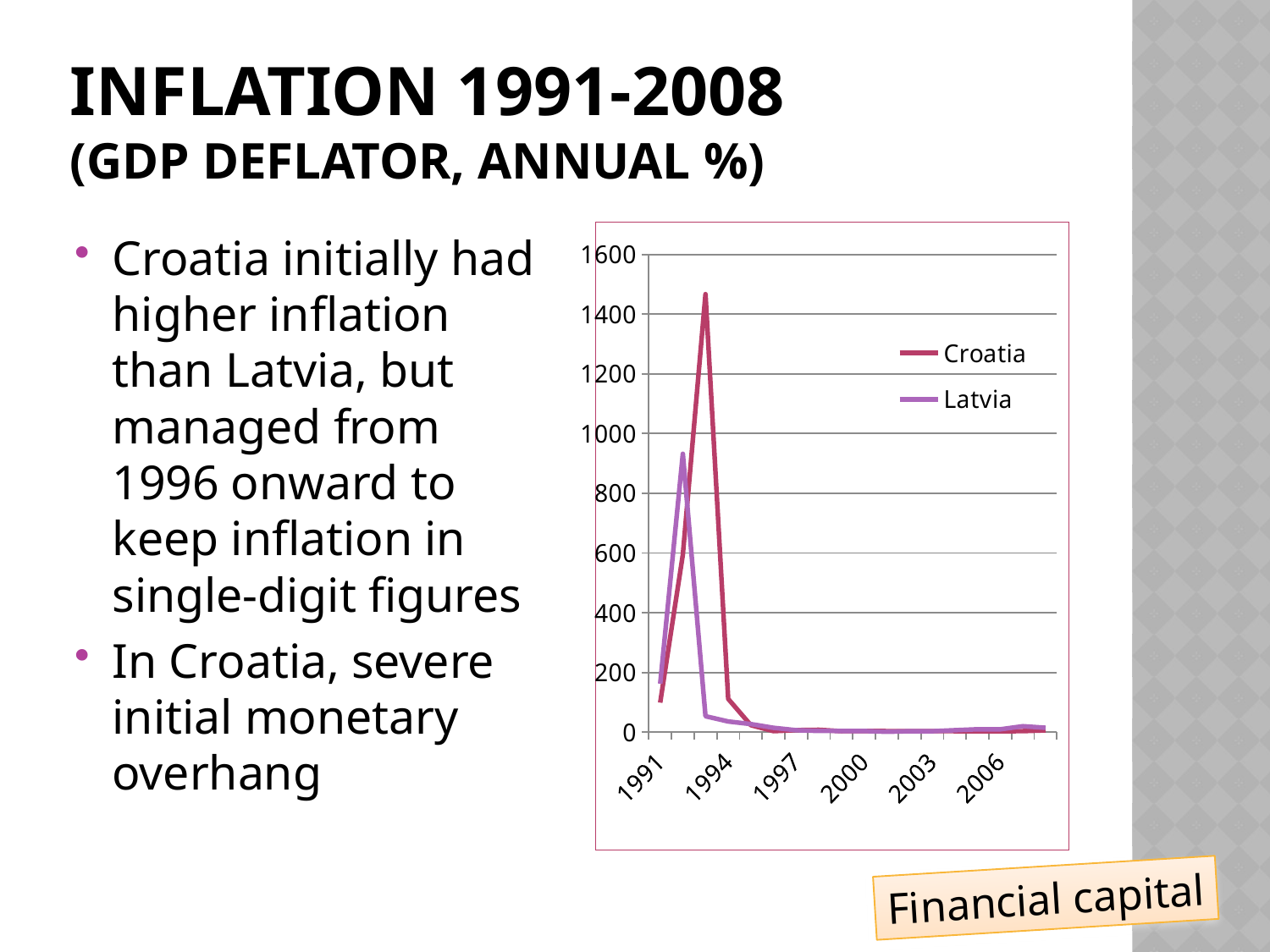
Which series reaches the higher peak value, Croatia or Latvia? Croatia What is the highest value shown on the chart's vertical axis? 1600 Is the peak value for Croatia greater or less than 1400? greater Which two countries are shown in the chart legend? Croatia and Latvia After reaching its peak, does the Croatia line rise or fall over the following years? fall How many year labels are printed along the x axis? 6 Is the value for Latvia in 1994 greater or less than 200? less Is the value for Croatia in 1991 greater or less than 200? less What kind of chart is shown on the slide? line chart How many series does the chart legend list? 2